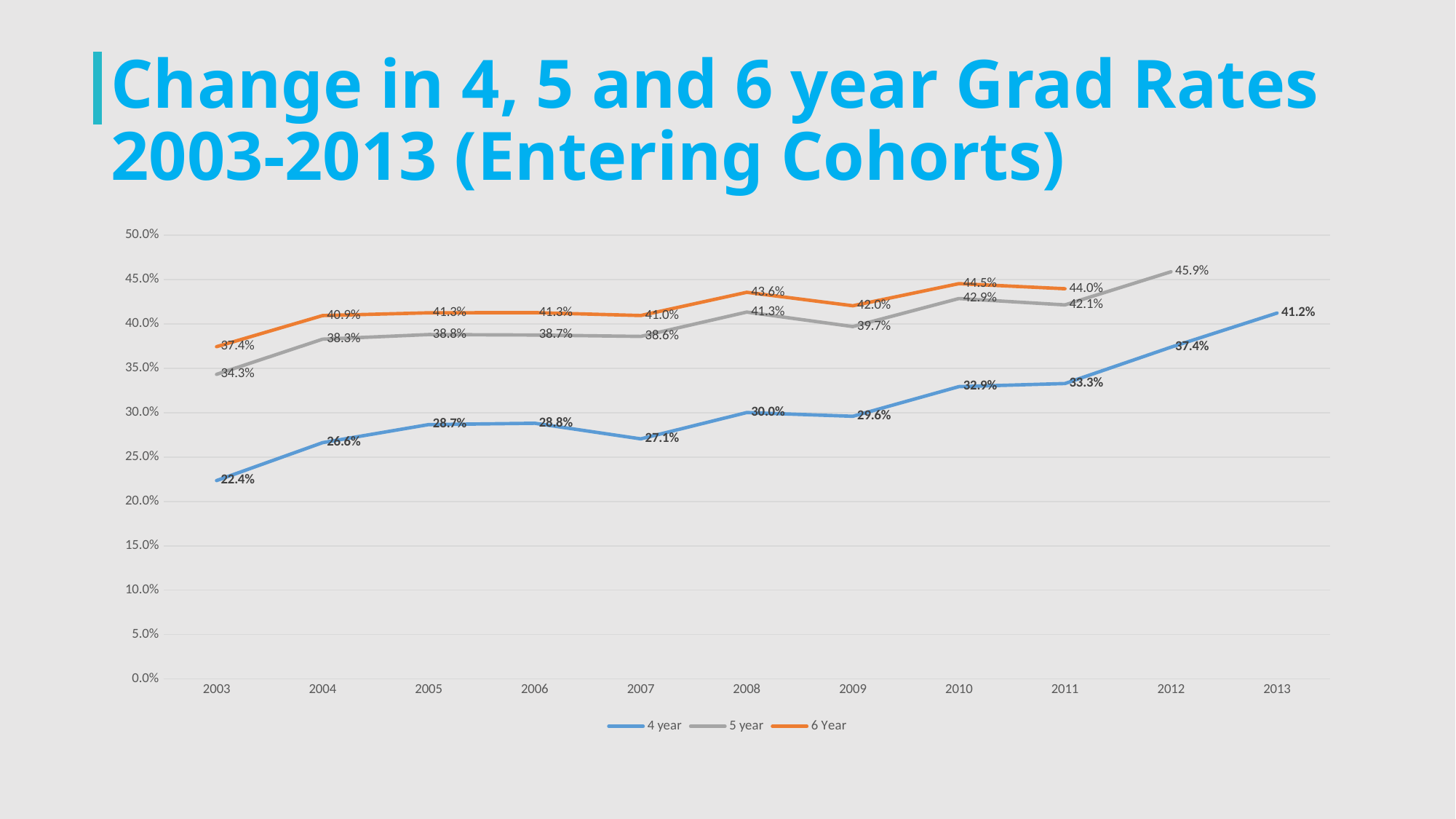
Which entering cohort has the lowest 4 year grad rate? 2003 What is the 4 year grad rate for the 2013 entering cohort? 41.2% Does the 4 year grad rate generally rise or fall from 2003 to 2013? Rise What is the 5 year grad rate for the 2012 entering cohort? 45.9% What colour is the line for the 6 Year series? Orange What type of chart is shown on the slide? Line chart What is the 6 Year grad rate for the 2008 entering cohort? 43.6% Which entering cohort has the highest 6 Year grad rate? 2010 How many series does the legend list? 3 How many entering cohort years are shown on the x axis? 11 What is the difference between the 4 year grad rates for the 2013 and 2003 cohorts? 18.8% Which is larger: the 5 year grad rate for 2010 or for 2011? 2010